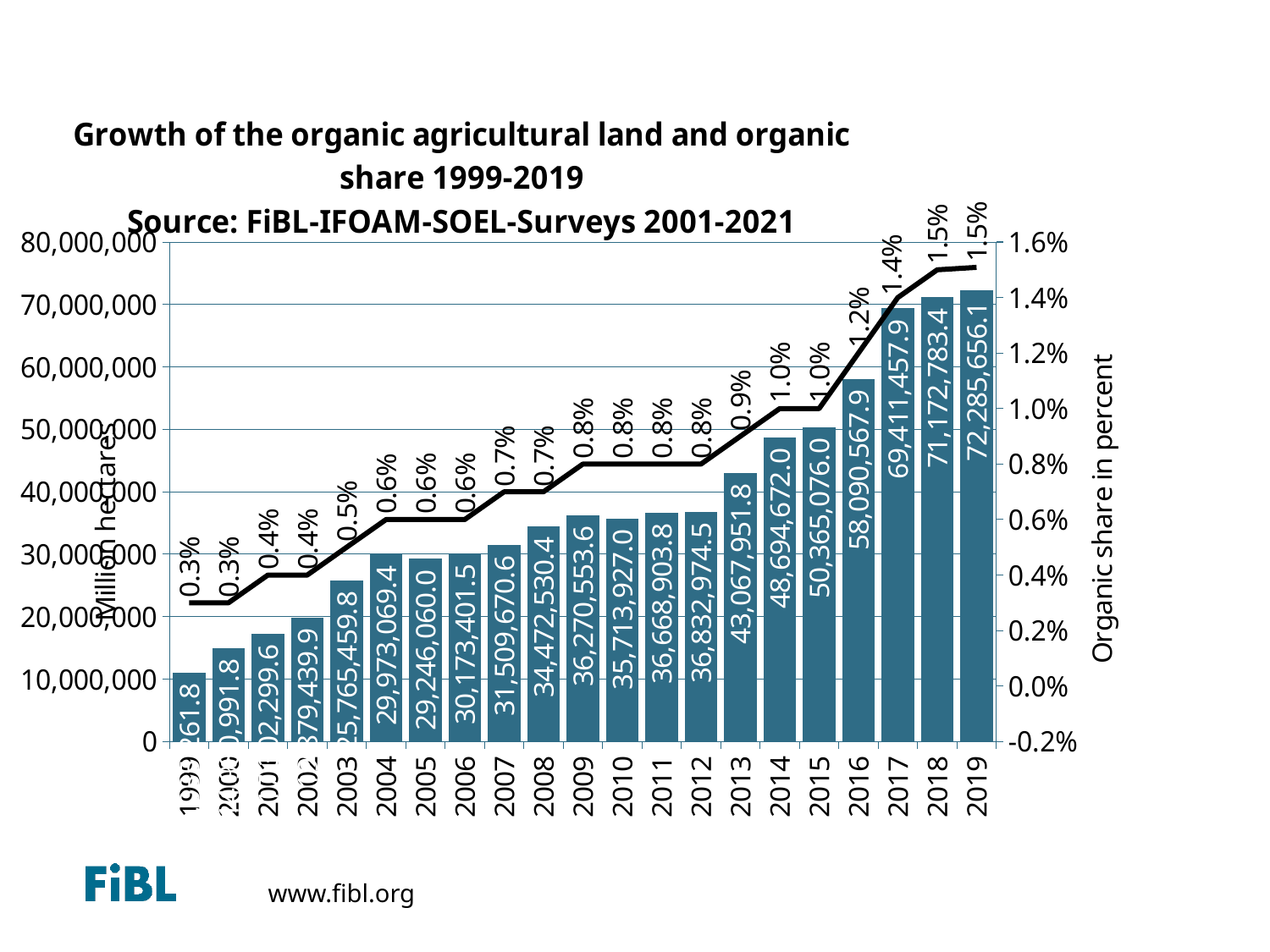
What is the organic agricultural land value shown for 2013? 43,067,951.8 Is the organic agricultural land value for 2016 greater or less than 50,000,000? greater What organic share in percent is shown for 2017? 1.4% How many years are shown on the x axis? 21 What organic share in percent is shown for 2003? 0.5% Which year has the larger organic agricultural land value, 2009 or 2010? 2009 Which year has the lowest organic agricultural land value? 1999 Does the organic share in percent generally rise or fall from 1999 to 2019? Rise What kind of chart is this? Bar chart with a line What is the organic agricultural land value shown for 2019? 72,285,656.1 What is the difference between the organic agricultural land values for 2019 and 2018? 1,112,872.7 Which year has the highest organic agricultural land value? 2019